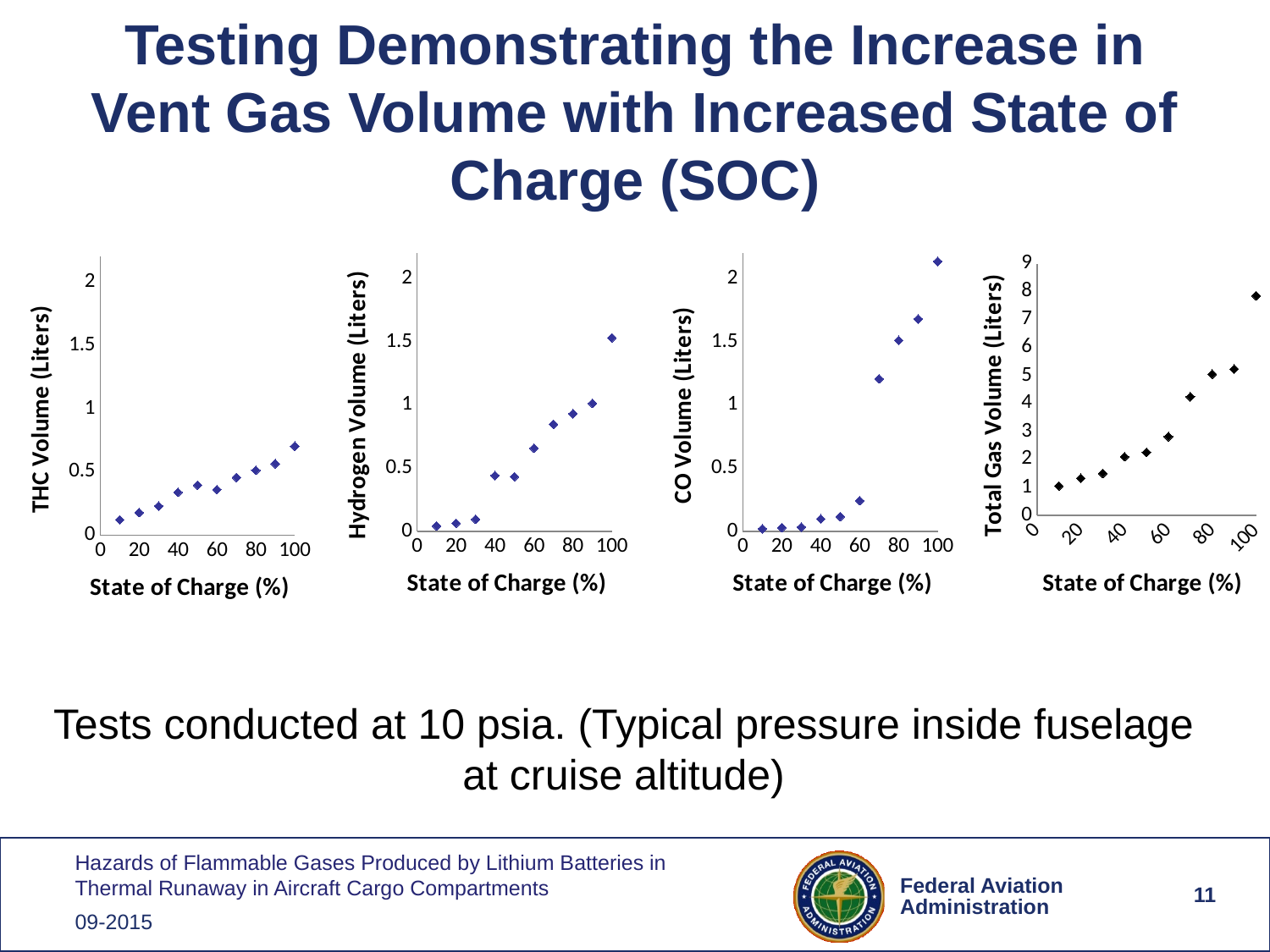
In the CO Volume chart, is the value at 100% State of Charge greater or less than 2? greater What kind of chart is the THC Volume chart on the left of the slide? scatter chart How many data points are plotted in the Total Gas Volume chart on the right? 10 In the Total Gas Volume chart, is the value at 100% State of Charge greater or less than 7? greater In the Total Gas Volume chart, do the values rise or fall as State of Charge increases? rise In the THC Volume chart, at which State of Charge is the THC volume highest? 100 How many data points are plotted in the Hydrogen Volume chart? 10 In the Hydrogen Volume chart, at which State of Charge is the hydrogen volume lowest? 10 What is the x-axis title shared by all four charts on the slide? State of Charge (%) In the CO Volume chart, do the values rise or fall as State of Charge increases? rise In the Hydrogen Volume chart, is the value at 100% State of Charge greater or less than 1? greater